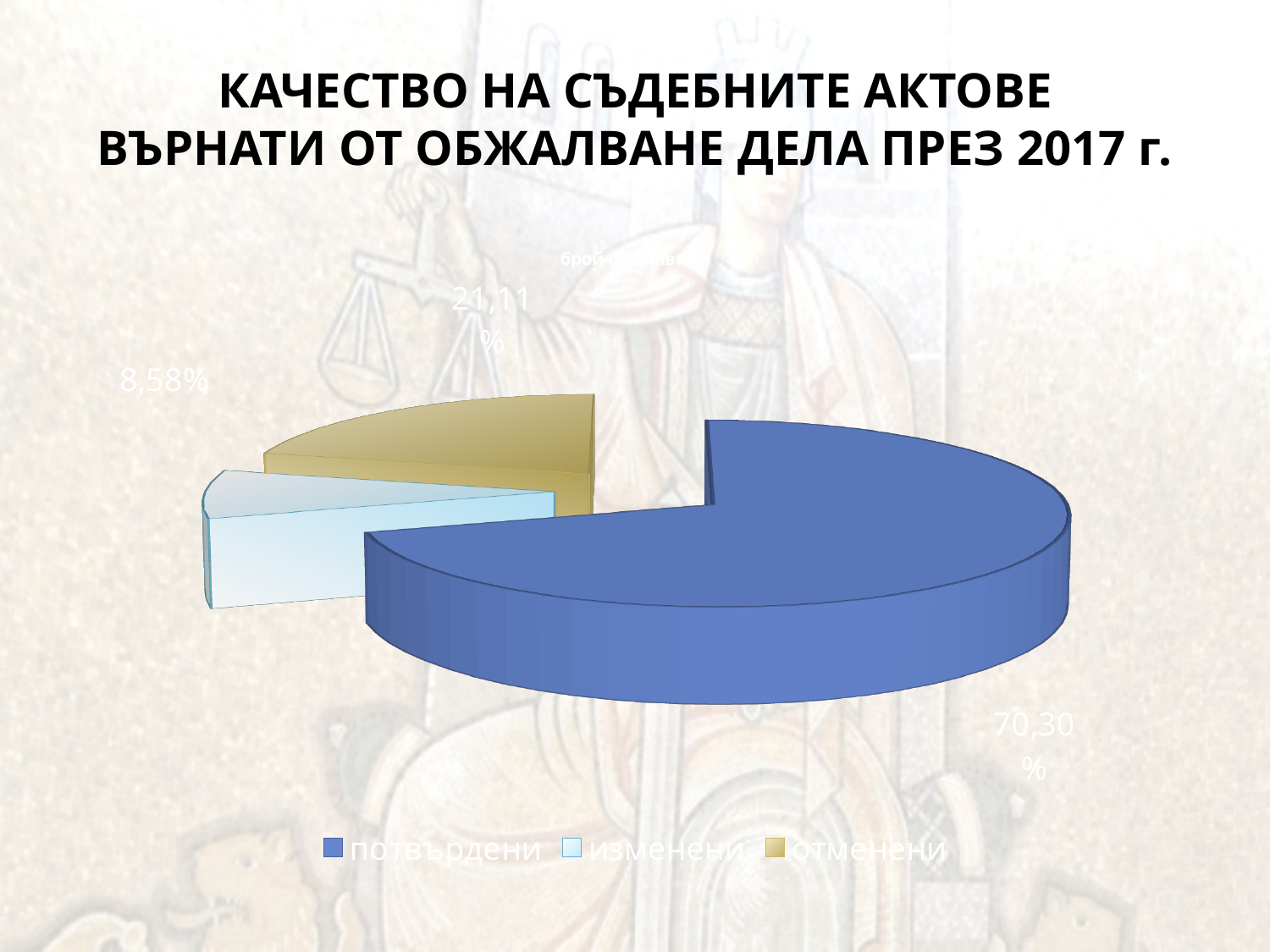
What is the difference between the values for отменени and изменени? 12,53% What kind of chart is shown on the slide? pie chart What is the value shown for отменени? 21,11% What colour is the slice for отменени? gold Which is larger, the slice for отменени or the slice for изменени? отменени What is the value shown for изменени? 8,58% How many slices does the pie chart have? 3 Which category has the smallest slice of the pie? изменени What is the value shown for потвърдени? 70,30% How many entries does the legend list? 3 What is the difference between the values for потвърдени and отменени? 49,19% Which category has the largest slice of the pie? потвърдени